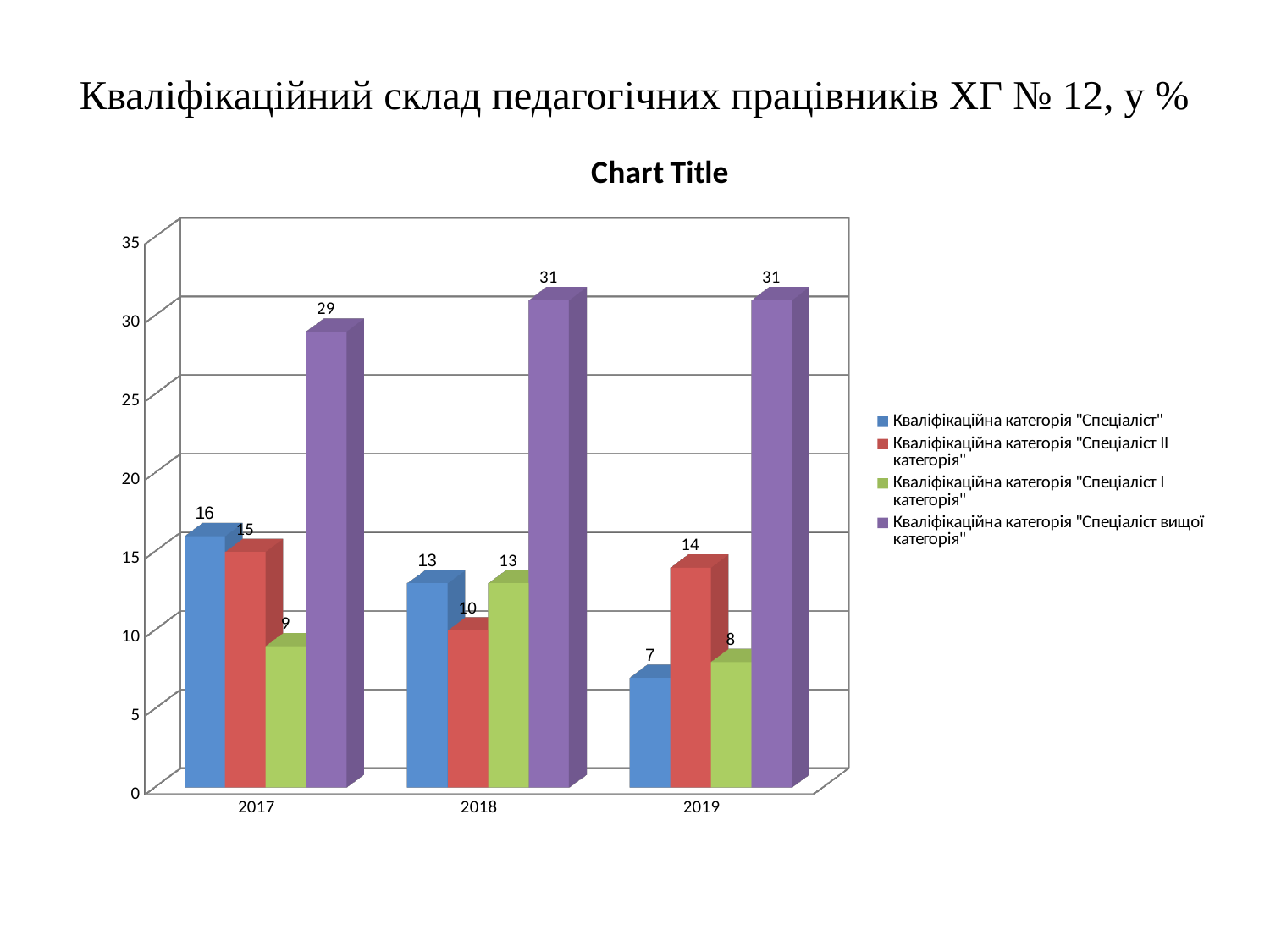
Which is larger in 2019: the value for Кваліфікаційна категорія "Спеціаліст II категорія" or for Кваліфікаційна категорія "Спеціаліст I категорія"? Кваліфікаційна категорія "Спеціаліст II категорія" What is the difference between the value for Кваліфікаційна категорія "Спеціаліст вищої категорія" in 2018 and in 2017? 2 What is the value for Кваліфікаційна категорія "Спеціаліст" in 2019? 7 In which year is the value for Кваліфікаційна категорія "Спеціаліст I категорія" the lowest? 2019 In which year is the value for Кваліфікаційна категорія "Спеціаліст" the highest? 2017 What is the value for Кваліфікаційна категорія "Спеціаліст II категорія" in 2018? 10 How many years are shown on the x axis? 3 How many series does the legend list? 4 What is the value for Кваліфікаційна категорія "Спеціаліст вищої категорія" in 2017? 29 What is the title printed above the chart? Chart Title Does the value for Кваліфікаційна категорія "Спеціаліст" fall or rise from 2017 to 2019? fall What type of chart is shown on the slide? bar chart